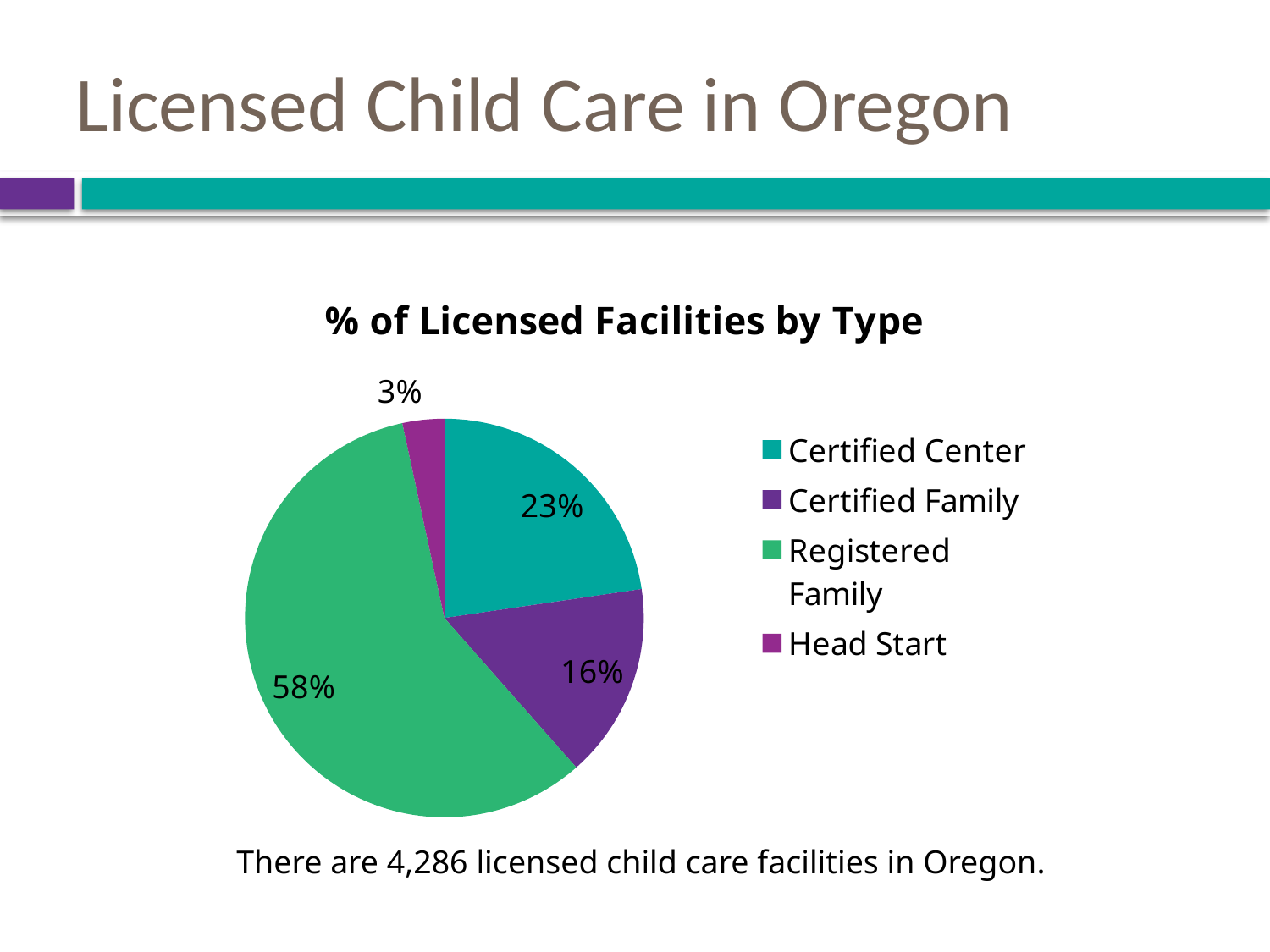
What type of chart is shown on the slide? pie chart Which is larger, the share for Certified Center or the share for Certified Family? Certified Center What percentage of licensed facilities are Registered Family? 58% How many slices does the pie chart have? 4 Which facility type has the largest share of the pie? Registered Family What is the difference in percentage points between Registered Family and Certified Center? 35 How many entries does the legend list? 4 What percentage of licensed facilities are Certified Center? 23% What percentage of licensed facilities are Head Start? 3% Which facility type has the smallest share of the pie? Head Start What is the title of the chart? % of Licensed Facilities by Type What percentage of licensed facilities are Certified Family? 16%